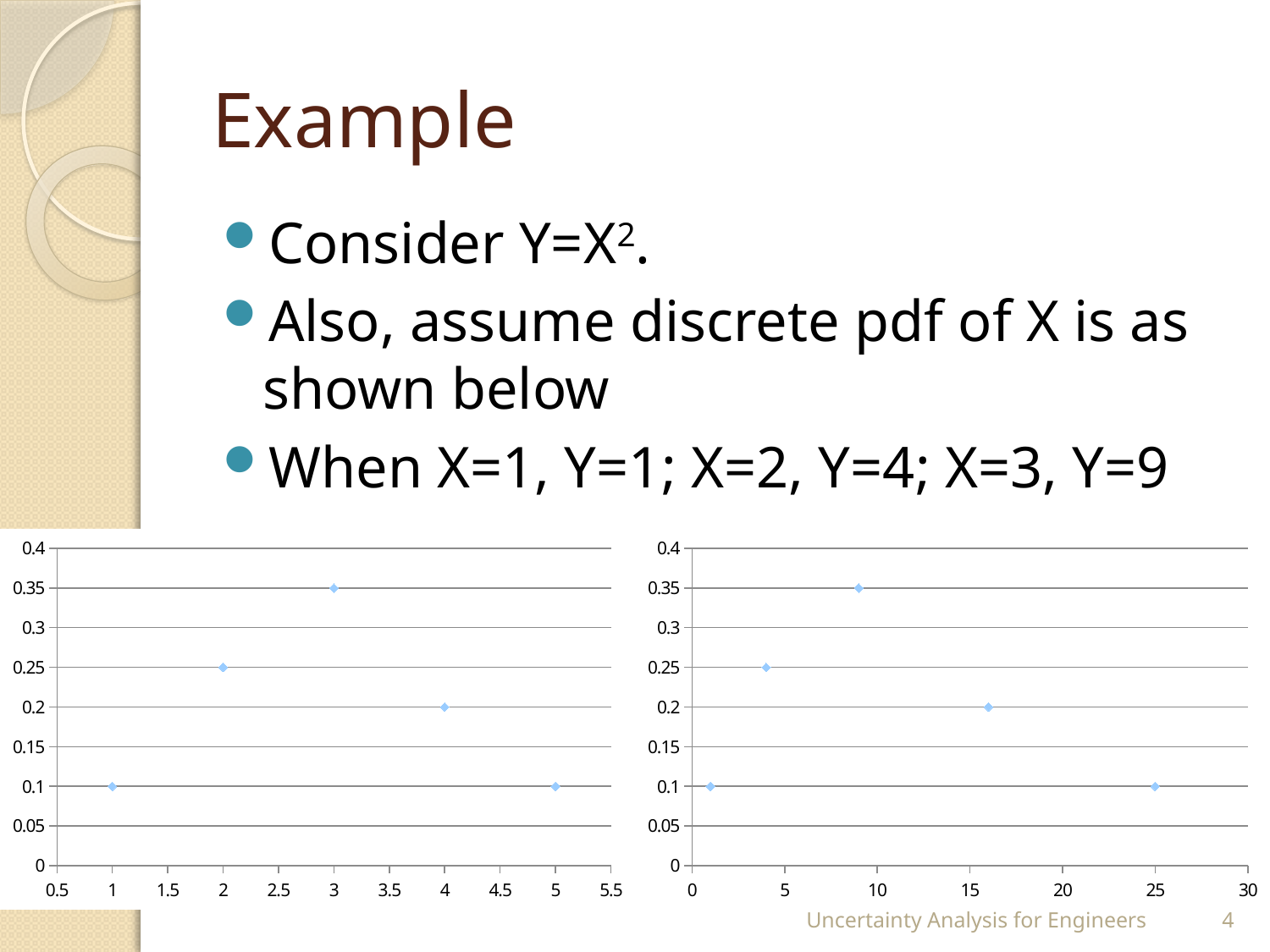
On the left chart, what is the difference between the values at x = 3 and x = 1? 0.25 On the left chart, what is the value plotted at x = 2? 0.25 On the left chart, what is the value plotted at x = 4? 0.2 On the right chart, what is the highest plotted value? 0.35 How many data points are plotted on the right chart? 5 On the right chart, is the value of the point between x = 15 and x = 20 greater or less than 0.3? less On the left chart, what is the value plotted at x = 3? 0.35 How many data points are plotted on the left chart? 5 On the left chart, at which x value is the plotted value highest? 3 What kind of chart is the right chart? Scatter chart On the right chart, what is the value plotted at x = 25? 0.1 On the left chart, which is larger: the value at x = 2 or the value at x = 4? x = 2